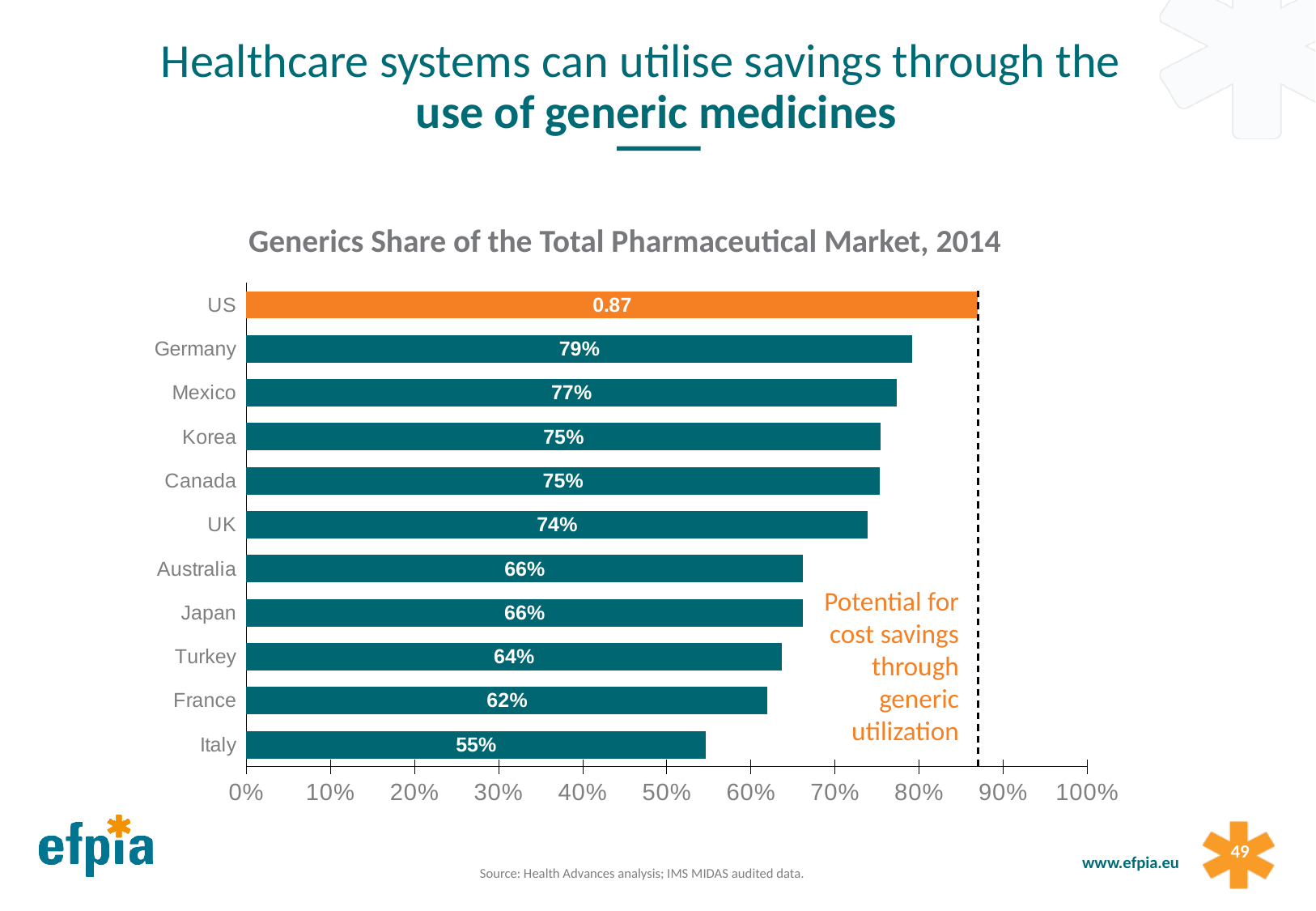
What is the generics share for Italy? 55% Is the value for Italy greater or less than 60%? less What is the difference between Germany's and France's generics share? 17% What is the generics share for Germany? 79% What is the generics share for Turkey? 64% What is the title of the chart? Generics Share of the Total Pharmaceutical Market, 2014 How many countries are shown in the chart? 11 Which country has the lowest generics share? Italy Which country has the highest generics share? US What value is printed on the US bar? 0.87 Which has a larger generics share, Mexico or UK? Mexico What kind of chart is shown on the slide? Bar chart